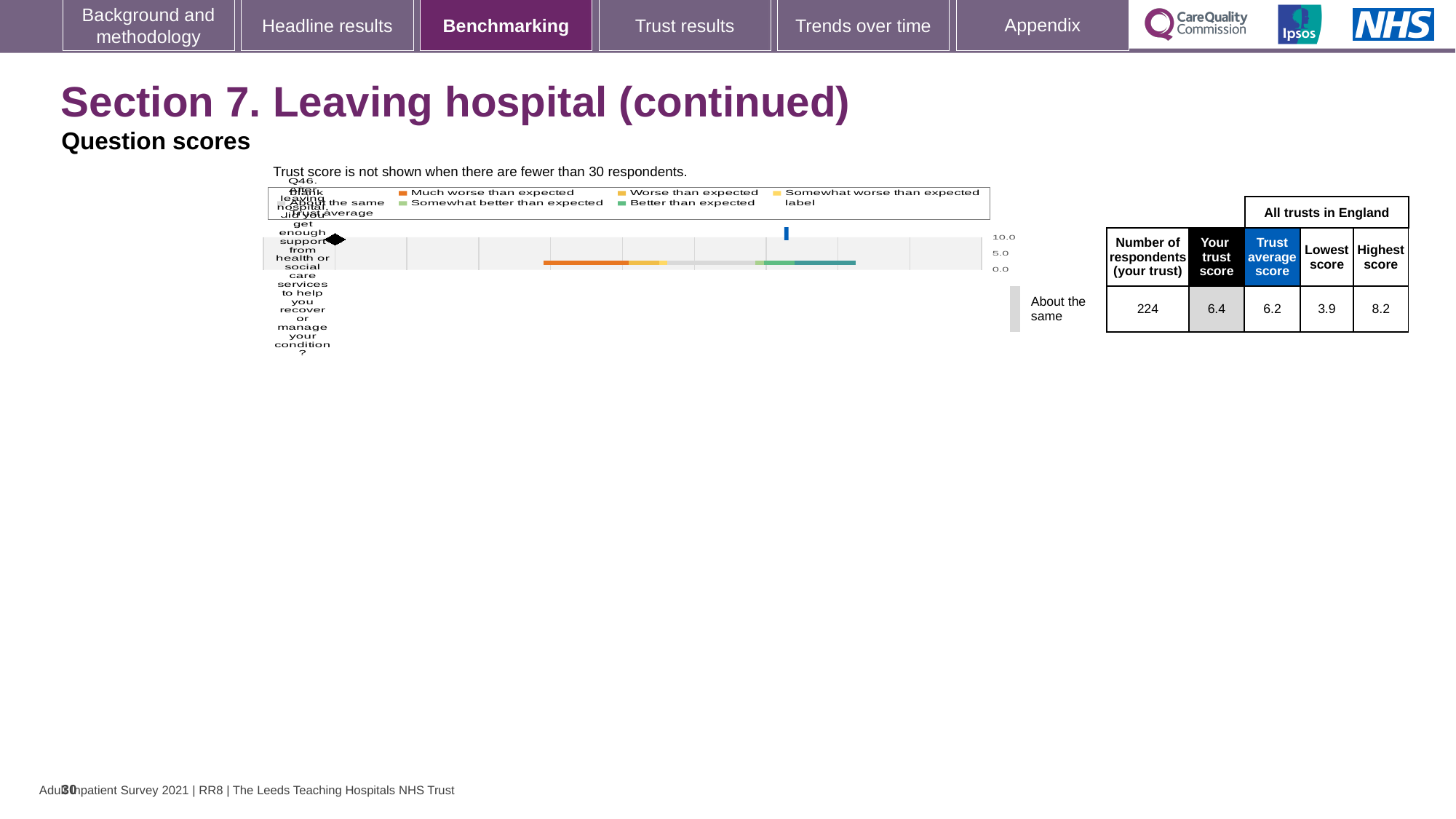
Which benchmark category is the trust's Q46 score placed in? About the same How many respondents from the trust answered Q46? 224 What is the highest score among all trusts in England for Q46? 8.2 What is the trust score for Q46 shown on the slide? 6.4 How many questions are plotted on the chart? 1 Is the trust score for Q46 greater or less than 5.0 on the chart axis? greater Which is larger for Q46: the trust's own score or the trust average score? Your trust score By how much does the trust score for Q46 exceed the trust average score? 0.2 What is the difference between the highest and lowest scores for Q46 across all trusts in England? 4.3 What is the lowest score among all trusts in England for Q46? 3.9 What is the trust average score for Q46 across all trusts in England? 6.2 What kind of chart is used to show the Q46 benchmark? Bar chart